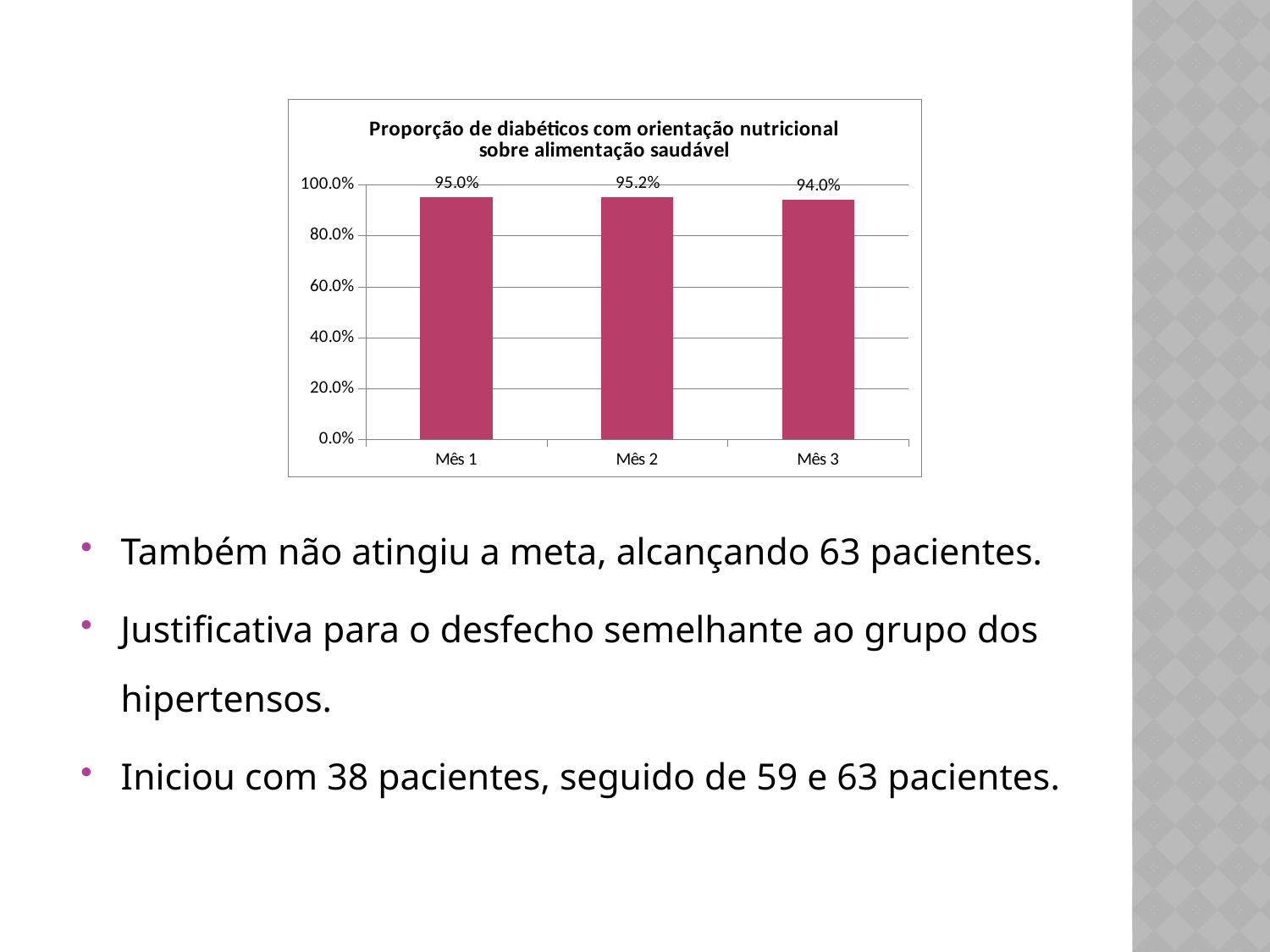
Which month has the highest value according to the data labels? Mês 2 How many months are shown on the x axis? 3 What kind of chart is shown on the slide? bar chart Is the value for Mês 1 greater or less than 80.0%? greater Does the value rise or fall from Mês 2 to Mês 3? fall What is the value for Mês 3? 94.0% What is the difference between the values for Mês 1 and Mês 3? 1.0% What is the value for Mês 2? 95.2% Which is larger, the value for Mês 1 or the value for Mês 3? Mês 1 What is the value for Mês 1? 95.0% Which month has the lowest value? Mês 3 What is the difference between the values for Mês 2 and Mês 3? 1.2%